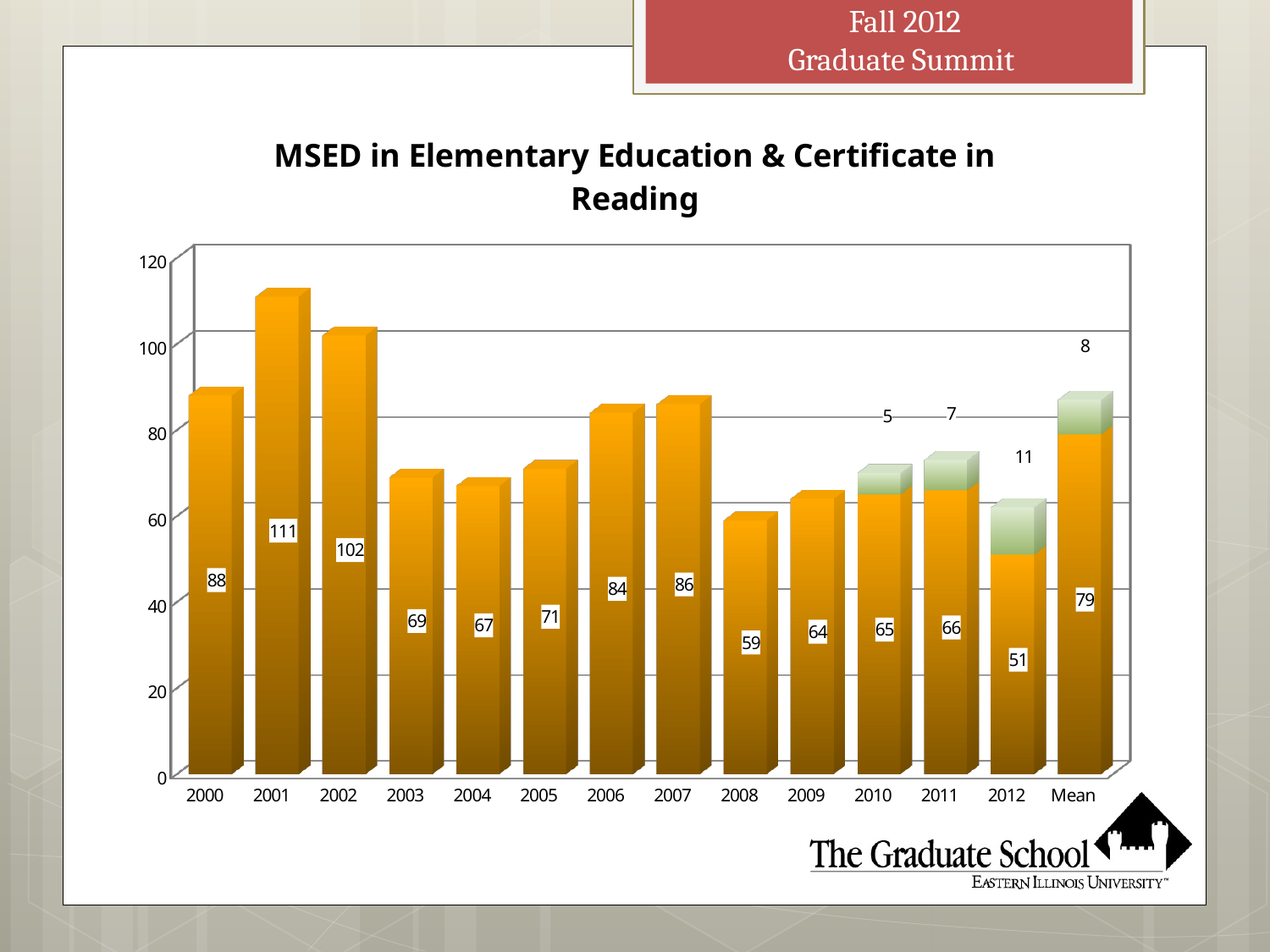
What is the value of the orange bar for Mean? 79 What is the value of the orange bar for 2008? 59 Which is larger, the orange bar value for 2006 or for 2007? 2007 What is the total of the stacked bar for 2012? 62 What is the total of the stacked bar for 2011? 73 What is the value of the green segment for 2012? 11 What is the difference between the orange bar values for 2001 and 2002? 9 Which year has the lowest orange bar value? 2012 Which year has the highest orange bar value? 2001 What kind of chart is shown on the slide? bar chart How many categories are shown on the x axis? 14 What is the value of the orange bar for 2001? 111